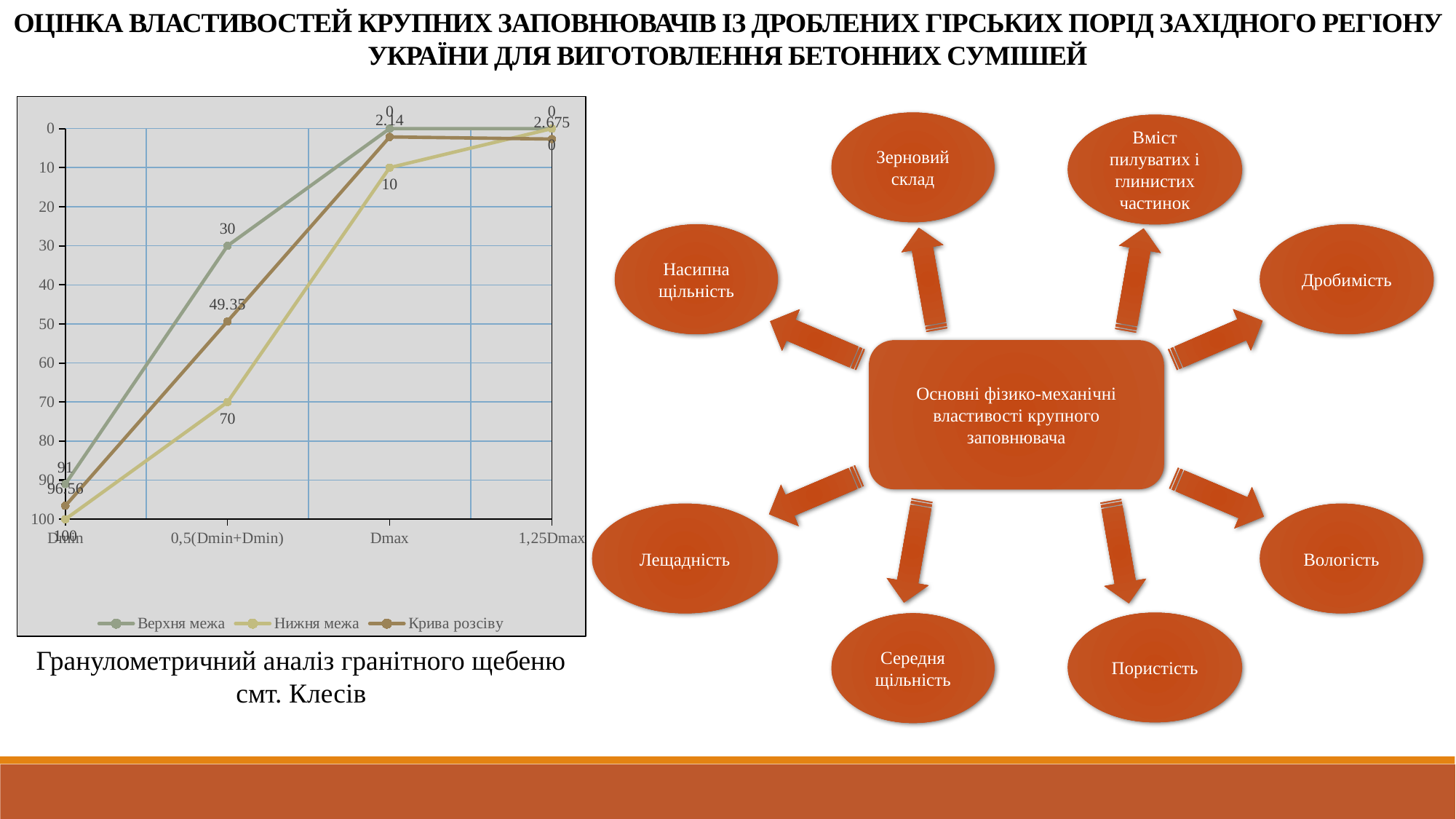
What is the difference between Нижня межа and Верхня межа at 0,5(Dmin+Dmin)? 40 How many categories are shown on the x axis of the chart? 4 At Dmax, which is larger: Нижня межа or Крива розсіву? Нижня межа What is the value of Нижня межа at Dmax? 10 What is the value of Крива розсіву at 0,5(Dmin+Dmin)? 49.35 What is the value of Крива розсіву at 1,25Dmax? 2.675 Do the values of Верхня межа rise or fall from Dmin to 1,25Dmax? Fall At which category does Нижня межа have its highest value? Dmin What type of chart is shown on the left of the slide? Line chart What is the value of Верхня межа at Dmin? 91 At which category does Крива розсіву have its lowest value? Dmax How many series does the legend of the chart list? 3